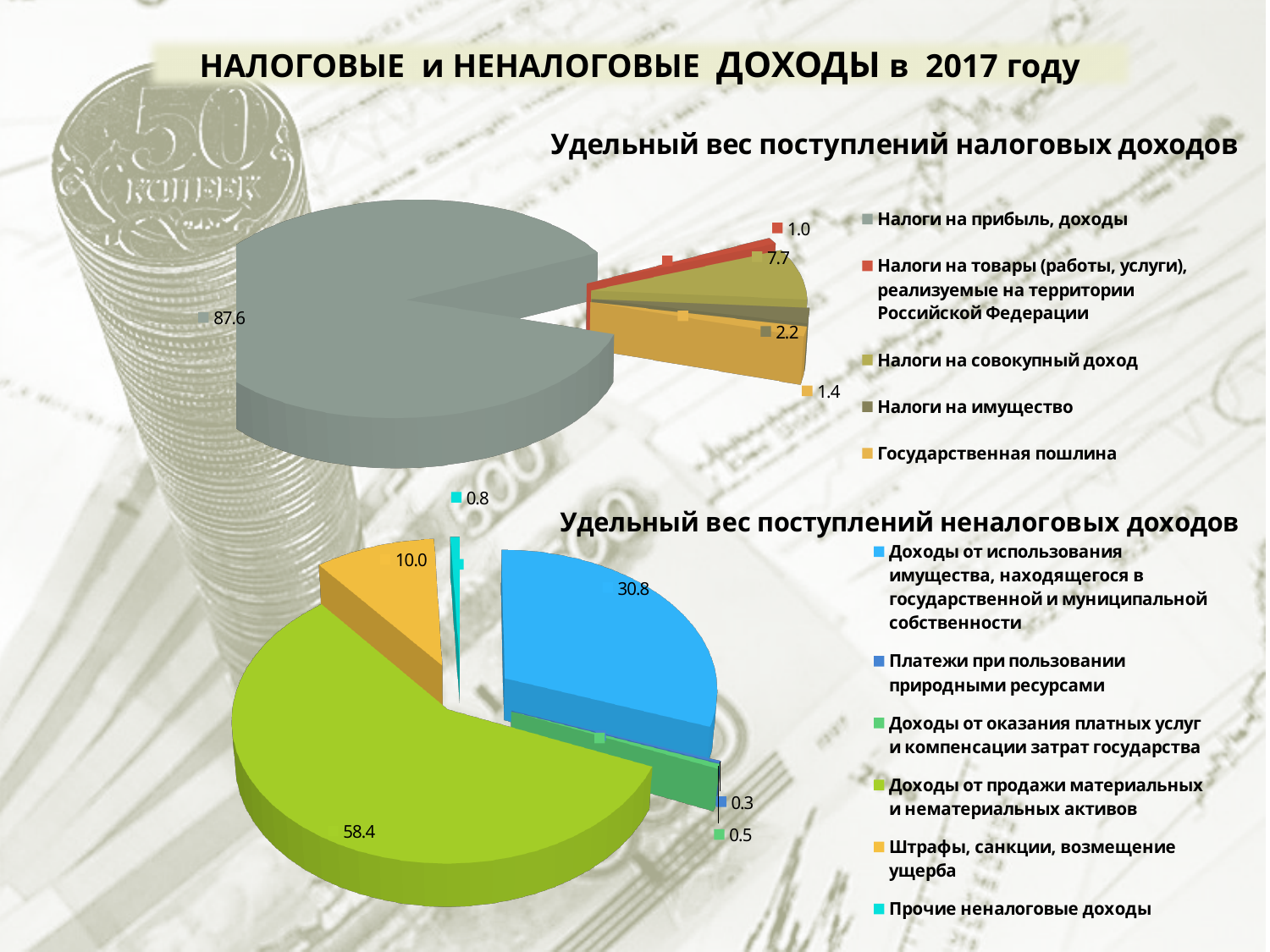
In the chart 'Удельный вес поступлений налоговых доходов', what is the difference between 'Налоги на имущество' and 'Государственная пошлина'? 0.8 In the chart 'Удельный вес поступлений неналоговых доходов', what is the difference between 'Доходы от продажи материальных и нематериальных активов' and 'Доходы от использования имущества, находящегося в государственной и муниципальной собственности'? 27.6 In the chart 'Удельный вес поступлений налоговых доходов', what is the value for 'Налоги на совокупный доход'? 7.7 In the chart 'Удельный вес поступлений неналоговых доходов', which category has the largest value? Доходы от продажи материальных и нематериальных активов In the chart 'Удельный вес поступлений налоговых доходов', how many categories does the legend list? 5 In the chart 'Удельный вес поступлений неналоговых доходов', which is larger: 'Платежи при пользовании природными ресурсами' or 'Прочие неналоговые доходы'? Прочие неналоговые доходы In the chart 'Удельный вес поступлений налоговых доходов', which category has the smallest value? Налоги на товары (работы, услуги), реализуемые на территории Российской Федерации In the chart 'Удельный вес поступлений неналоговых доходов', what is the value for 'Доходы от продажи материальных и нематериальных активов'? 58.4 In the chart 'Удельный вес поступлений налоговых доходов', what is the value for 'Налоги на прибыль, доходы'? 87.6 In the chart 'Удельный вес поступлений неналоговых доходов', what is the value for 'Штрафы, санкции, возмещение ущерба'? 10.0 What type of chart is 'Удельный вес поступлений неналоговых доходов'? Pie chart In the chart 'Удельный вес поступлений неналоговых доходов', how many categories does the legend list? 6